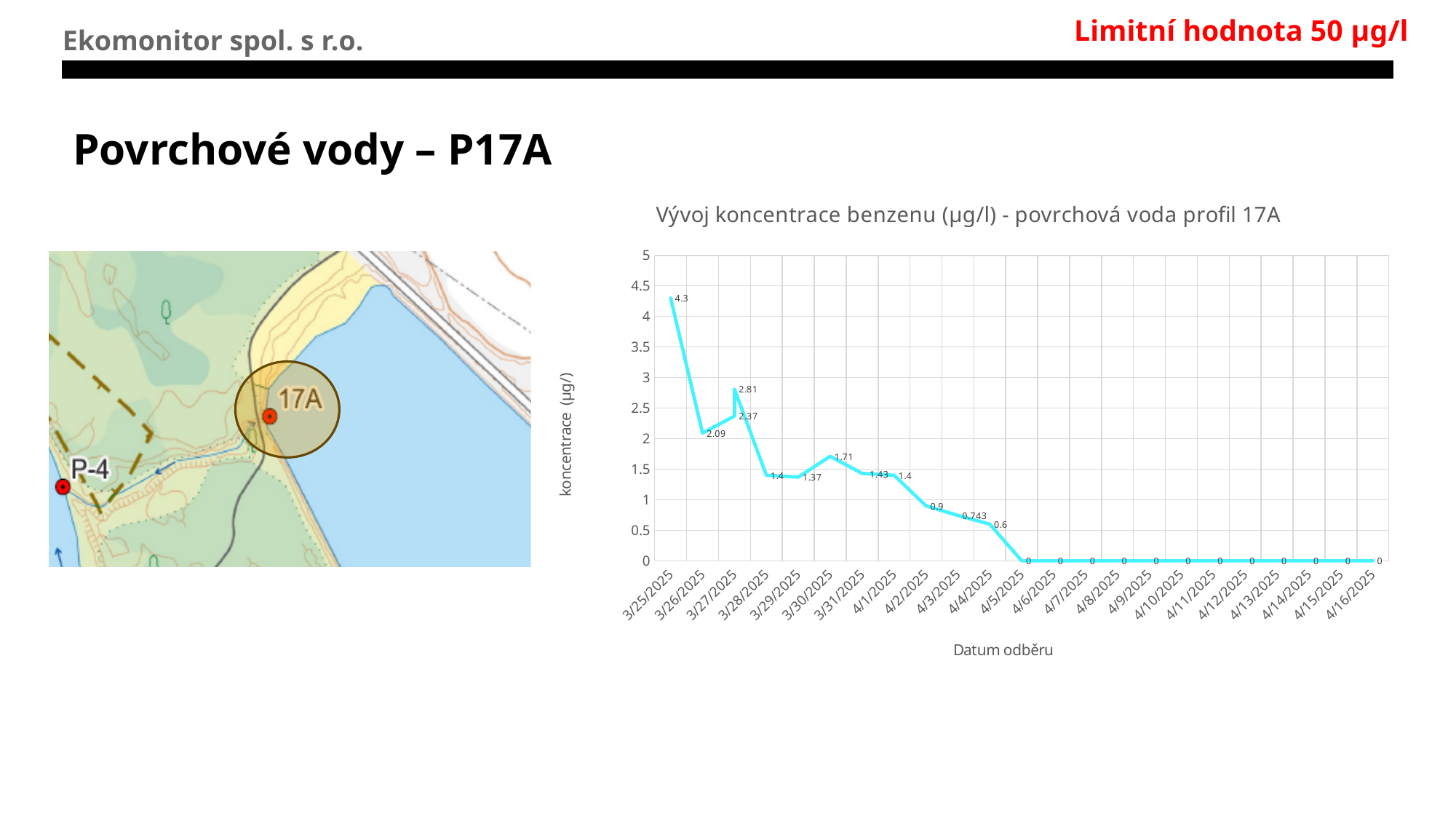
What is the difference between the concentration on 3/30/2025 and on 3/29/2025? 0.34 What is the benzene concentration on 4/10/2025? 0 What is the title of the chart's x axis? Datum odběru What is the benzene concentration on 3/26/2025? 2.09 What is the benzene concentration on 4/3/2025? 0.743 Which date has the higher concentration, 3/30/2025 or 3/31/2025? 3/30/2025 Overall, do the concentration values rise or fall from 3/25/2025 to 4/16/2025? fall What is the benzene concentration on 3/30/2025? 1.71 What is the difference between the concentration on 3/25/2025 and on 3/26/2025? 2.21 What type of chart is shown on the slide? line chart On which date is the benzene concentration highest? 3/25/2025 What is the benzene concentration on 3/25/2025? 4.3